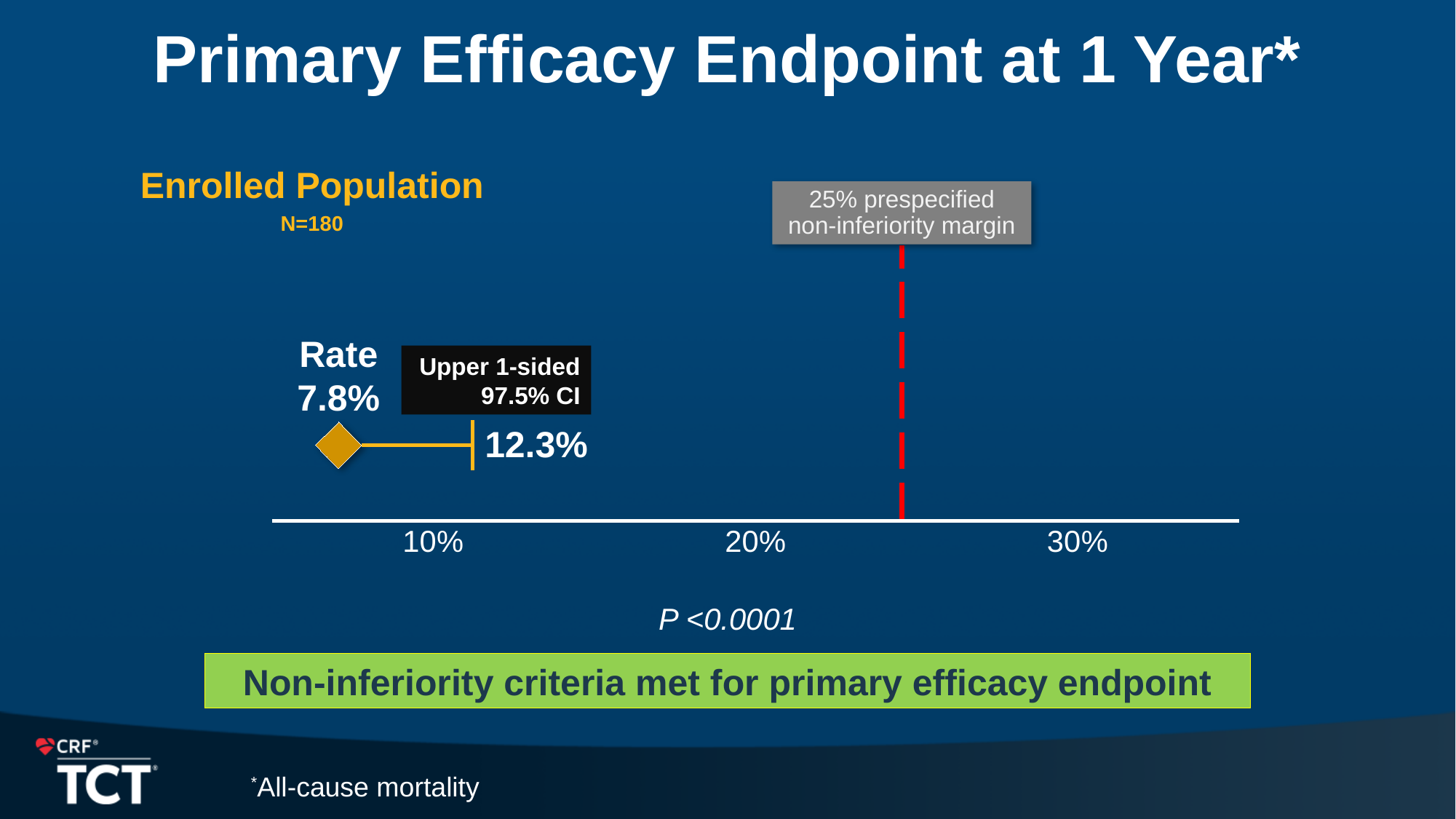
How many point estimates are plotted on the chart? 1 What is the prespecified non-inferiority margin marked by the red dashed line? 25% Is the rate for the enrolled population greater or less than 10%? less What is the upper 1-sided 97.5% confidence interval bound shown on the chart? 12.3% What is the primary efficacy endpoint rate for the enrolled population? 7.8% Which is larger, the upper 1-sided 97.5% CI bound or the prespecified non-inferiority margin? The non-inferiority margin What is the difference between the upper 1-sided 97.5% CI bound and the point estimate rate? 4.5 percentage points What does the red dashed vertical line on the chart represent? 25% prespecified non-inferiority margin Is the upper 1-sided 97.5% CI bound greater or less than 10%? greater What is the sample size (N) of the enrolled population shown on the chart? 180 Is the upper 1-sided 97.5% CI bound greater or less than 20%? less By how much is the 25% non-inferiority margin above the upper 1-sided 97.5% CI bound of 12.3%? 12.7 percentage points